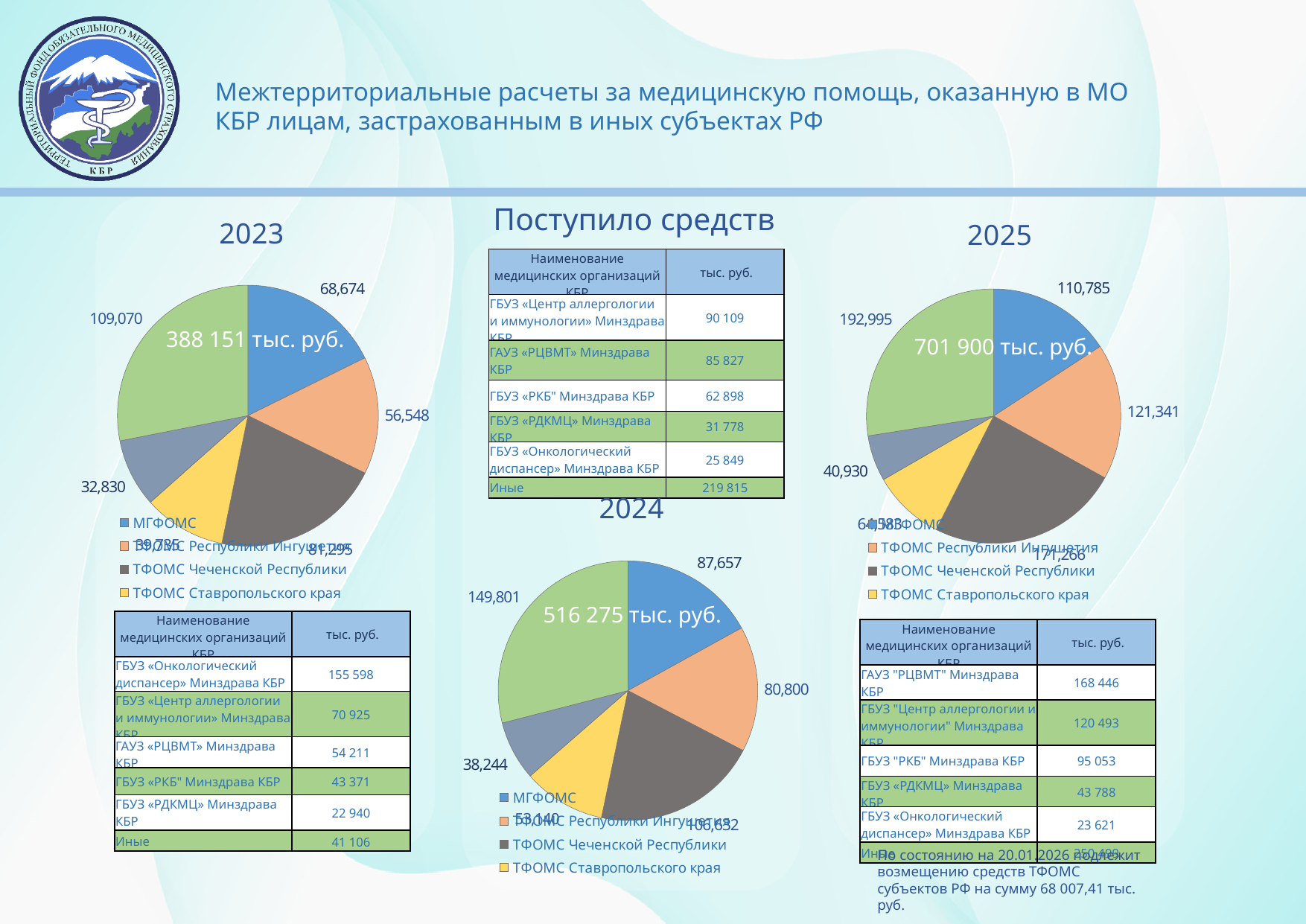
In the 2023 chart, what is the value of the largest slice? 109,070 What total is printed in the centre of the 2023 pie chart? 388 151 тыс. руб. How many slices does the 2024 pie chart have? 6 Do the totals printed in the centres of the pie charts rise or fall from 2023 to 2025? rise In the 2024 chart, what is the value for ТФОМС Республики Ингушетия? 80,800 In the 2023 chart, what is the value for МГФОМС? 68,674 In the 2023 chart, what is the value for ТФОМС Республики Ингушетия? 56,548 In the 2025 chart, what is the difference between ТФОМС Республики Ингушетия and МГФОМС? 10,556 In the 2025 chart, which is larger: МГФОМС or ТФОМС Республики Ингушетия? ТФОМС Республики Ингушетия In the 2024 chart, how much larger is МГФОМС than ТФОМС Республики Ингушетия? 6,857 In the 2024 chart, what is the value for МГФОМС? 87,657 What kind of chart is the 2023 chart? pie chart